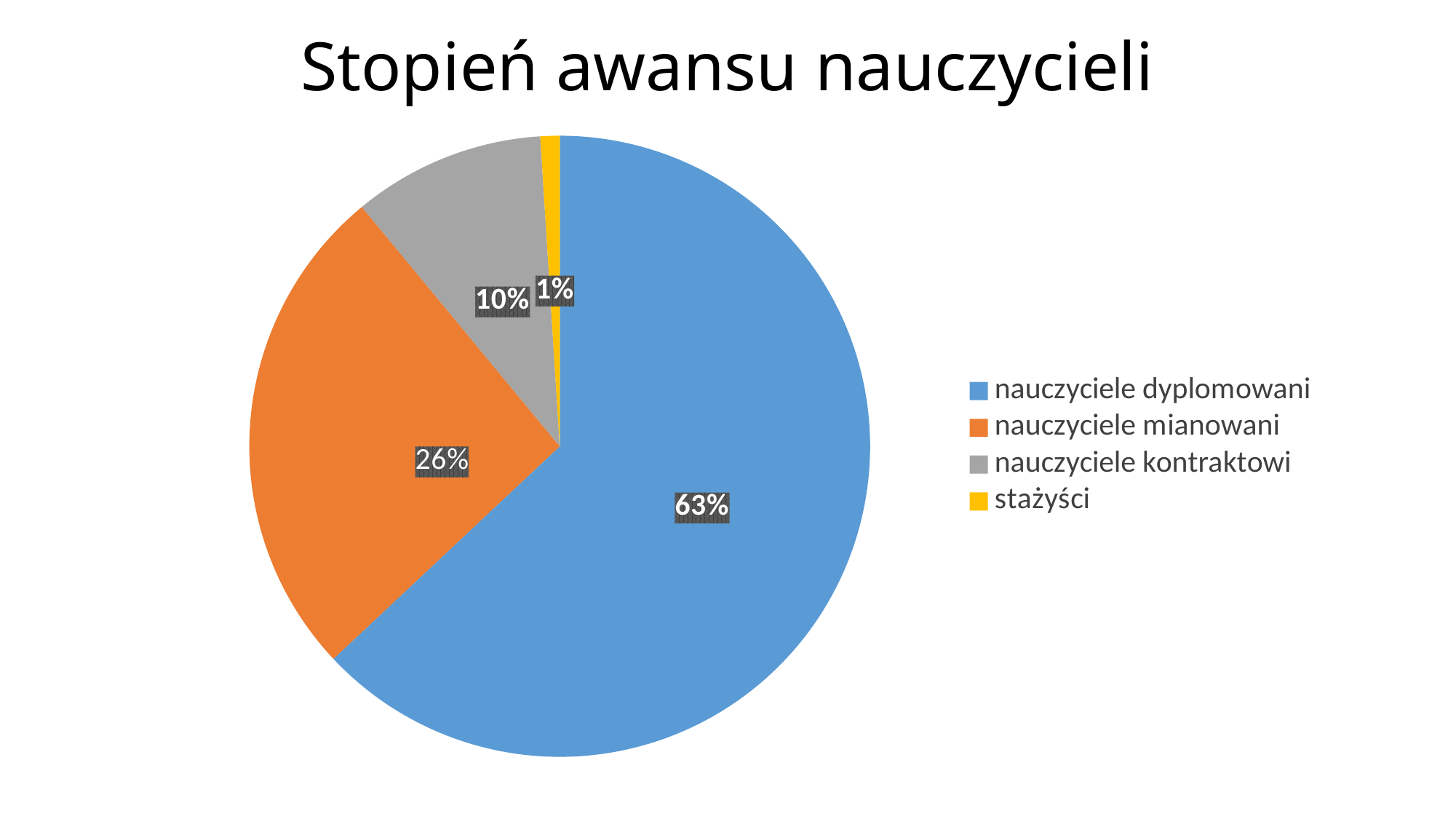
What kind of chart is shown on the slide? pie chart What share of the pie is labelled for nauczyciele dyplomowani? 63% What is the difference in percentage points between nauczyciele dyplomowani and nauczyciele mianowani? 37 How many categories does the pie chart show? 4 What share of the pie is labelled for stażyści? 1% What share of the pie is labelled for nauczyciele mianowani? 26% What is the title of the chart? Stopień awansu nauczycieli Which category has the smallest slice of the pie? stażyści Which category has the largest slice of the pie? nauczyciele dyplomowani Which is larger, the slice for nauczyciele mianowani or the slice for nauczyciele kontraktowi? nauczyciele mianowani What colour is the slice for stażyści? yellow What share of the pie is labelled for nauczyciele kontraktowi? 10%